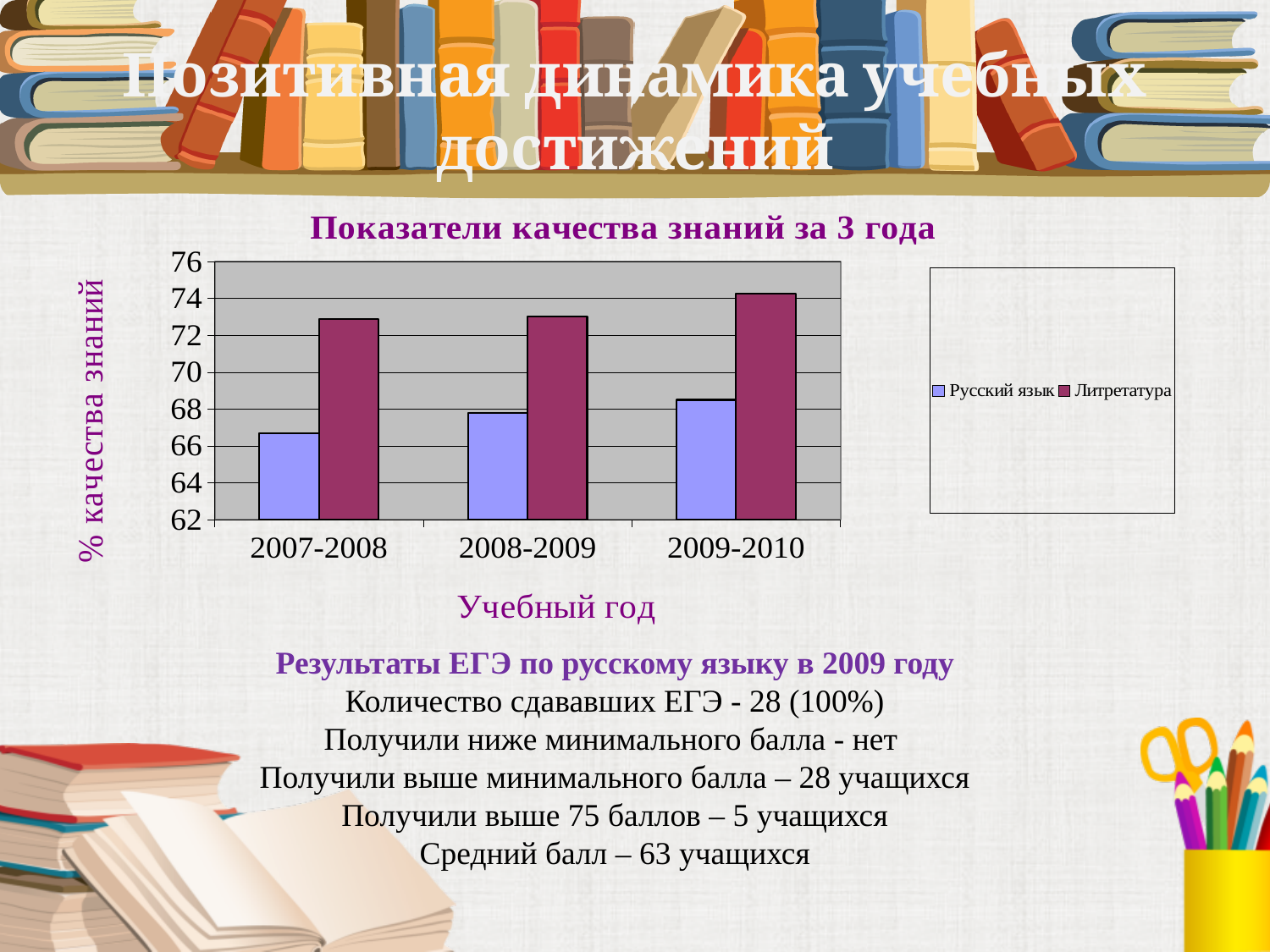
Is the value for Русский язык in 2009-2010 greater or less than 70? less In 2008-2009, which series has the larger value, Русский язык or Литретатура? Литретатура What kind of chart is shown on the slide? bar chart In which academic year is the value for Литретатура the highest? 2009-2010 Do the values for Русский язык rise or fall from 2007-2008 to 2009-2010? rise Is the value for Русский язык in 2007-2008 greater or less than 68? less In which academic year is the value for Русский язык the lowest? 2007-2008 How many series does the legend list? 2 What is the title of the chart? Показатели качества знаний за 3 года Is the value for Литретатура in 2007-2008 greater or less than 72? greater What is the label of the x axis? Учебный год How many academic years are shown on the x axis? 3